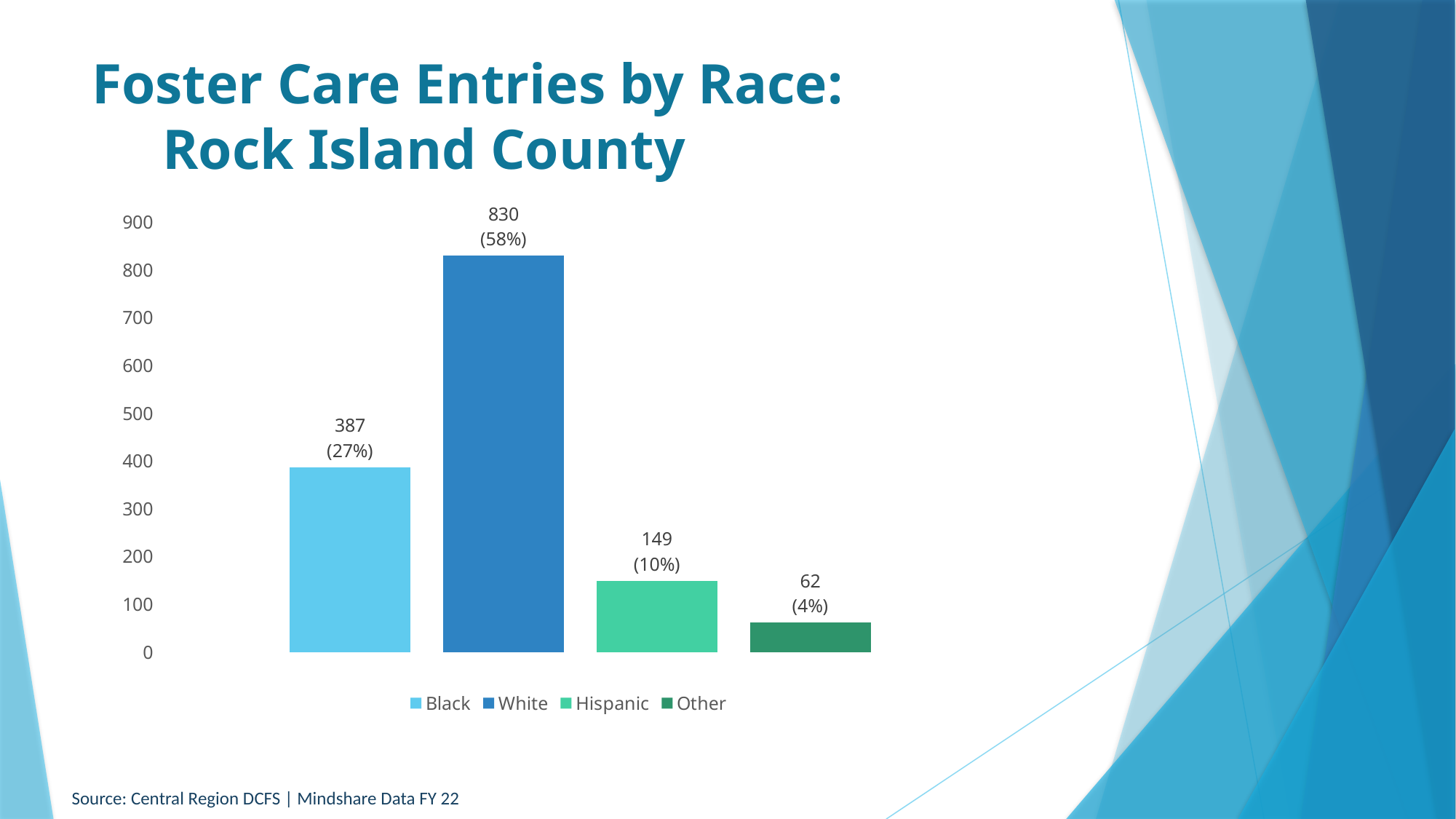
Is the value for Black greater or less than 300? greater What is the title of the slide? Foster Care Entries by Race: Rock Island County What percentage of foster care entries is shown for Hispanic? 10% What is the number of foster care entries for Other? 62 Which has more foster care entries, Hispanic or Other? Hispanic What is the difference between the number of entries for White and Black? 443 What is the number of foster care entries for Black? 387 Which race category has the highest number of foster care entries? White How many race categories are shown in the chart? 4 What kind of chart is shown on the slide? Bar chart Which race category has the lowest number of foster care entries? Other What is the number of foster care entries for White? 830